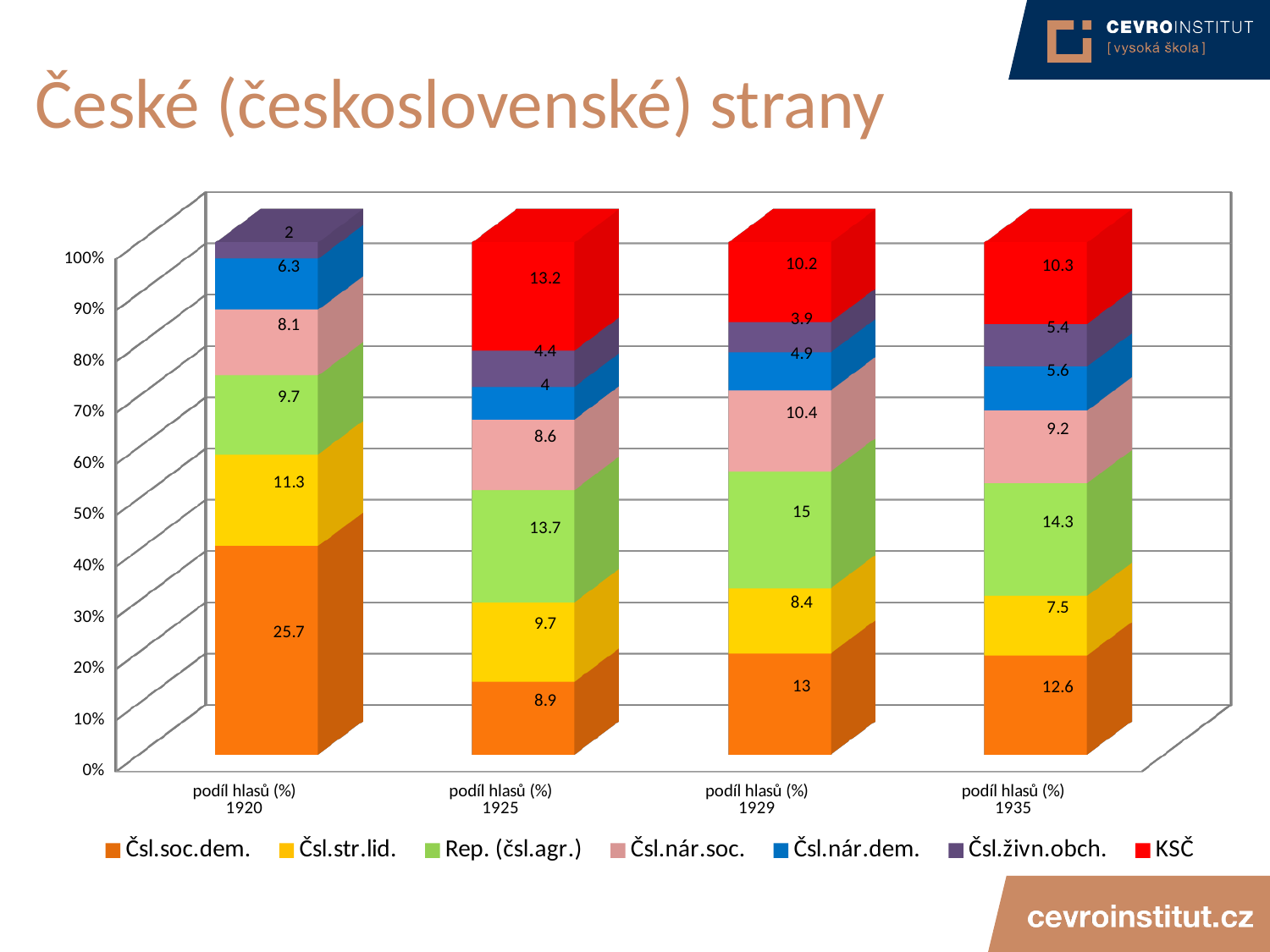
In which year is the value for Čsl.str.lid. lowest? 1935 Which series is shown in red in the legend? KSČ What is the value for Čsl.nár.dem. in 1935? 5.6 How many series does the legend list? 7 How many years (categories) are shown on the x axis? 4 What is the difference between the Čsl.soc.dem. values in 1920 and 1925? 16.8 What is the value for KSČ in 1925? 13.2 In which year is the value for Čsl.soc.dem. highest? 1920 What is the value for Čsl.soc.dem. in 1920? 25.7 What kind of chart is shown on the slide? Stacked bar chart Which is larger in 1929: the value for Čsl.nár.soc. or the value for KSČ? Čsl.nár.soc. What is the value for Rep. (čsl.agr.) in 1929? 15